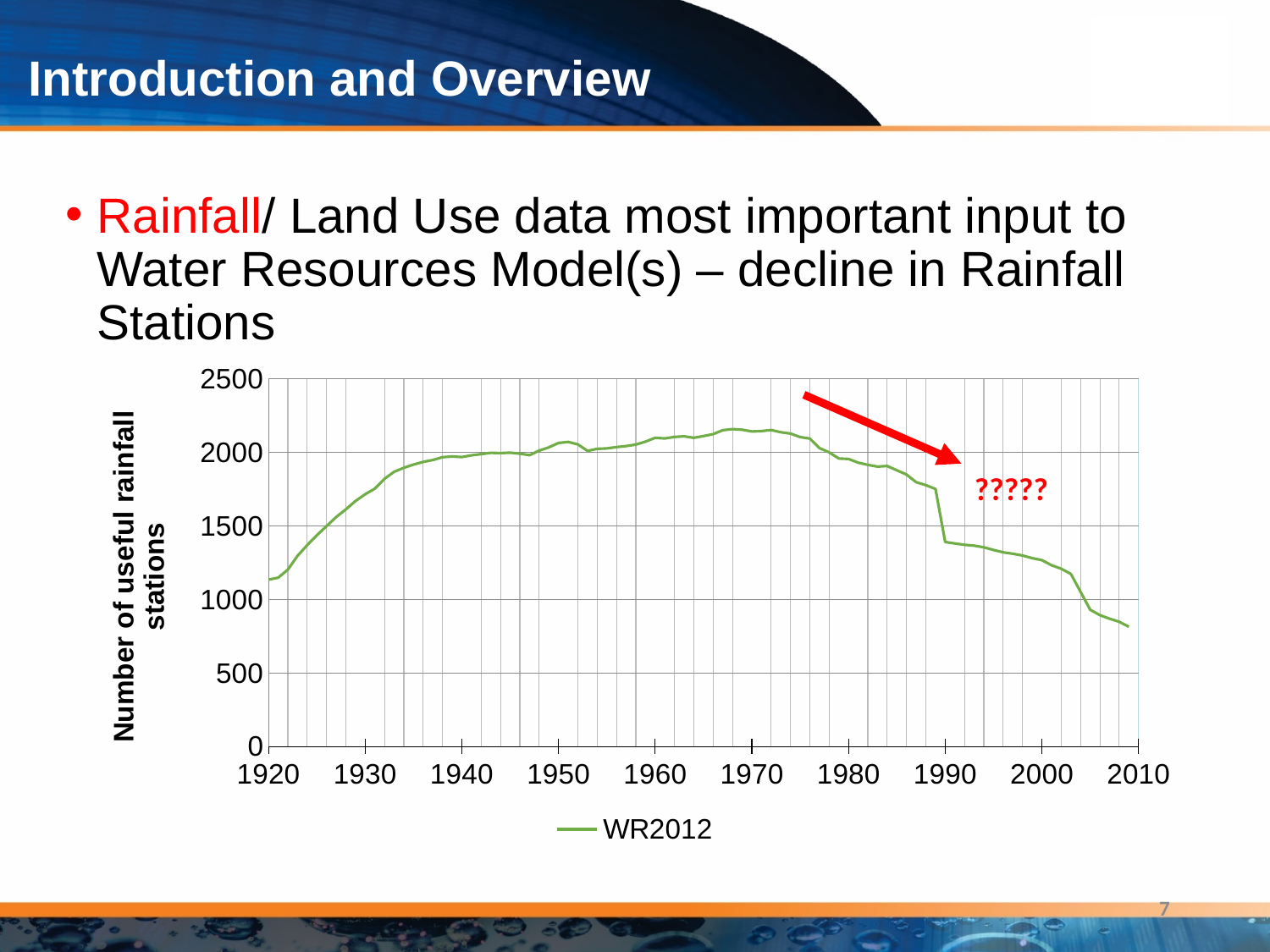
What kind of chart is shown on the slide? line chart How many series does the legend list? 1 Do the values rise or fall between 1990 and 2010? fall Is the value for 1920 greater or less than 1000? greater Is the value for 1930 greater or less than 1500? greater What is the title of the vertical axis? Number of useful rainfall stations Is the value for 1970 greater or less than 2000? greater What is the name of the series shown in the legend? WR2012 Do the values rise or fall between 1920 and 1930? rise